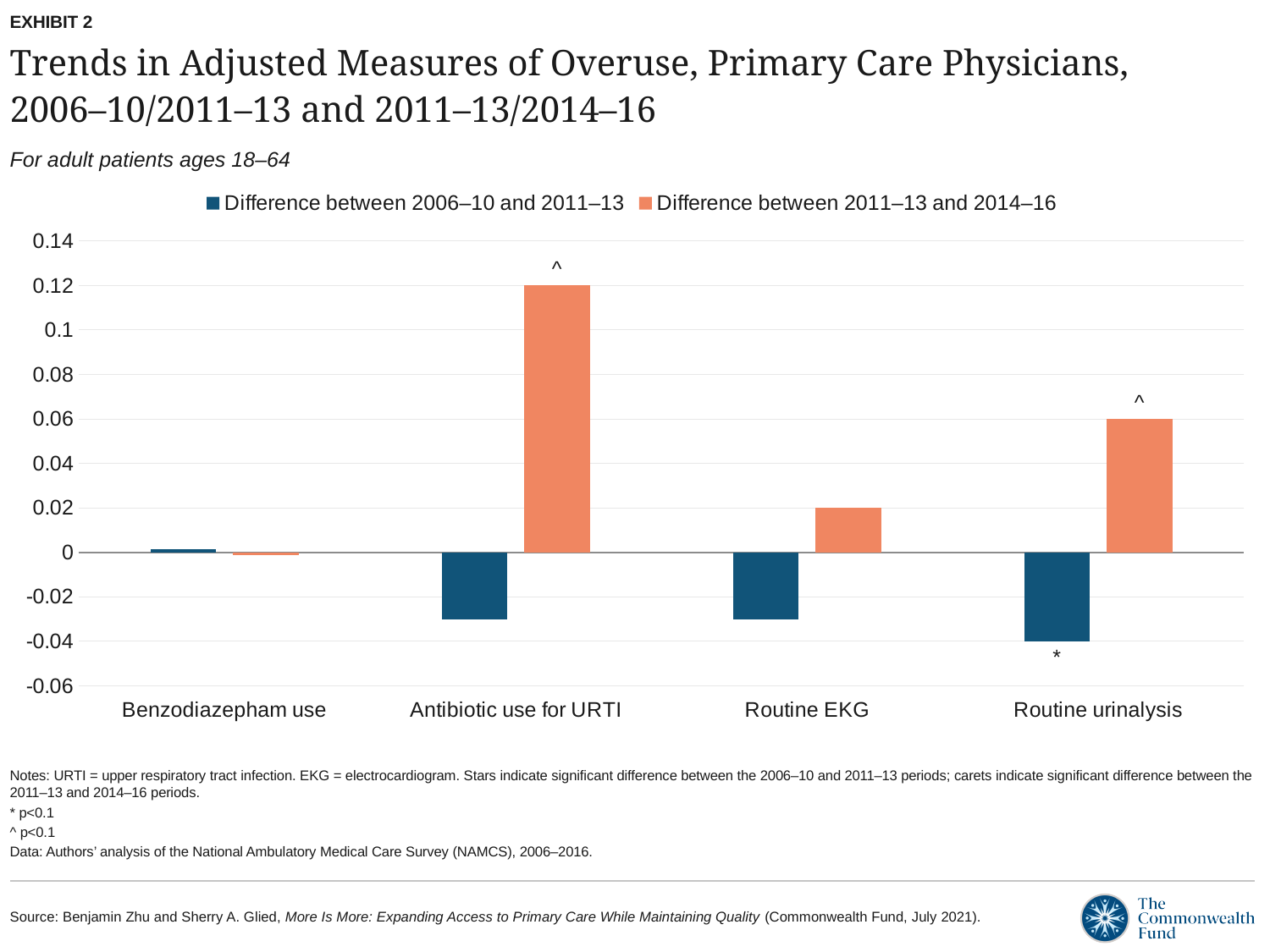
How many series does the legend list? 2 What colour are the bars for the 'Difference between 2011–13 and 2014–16' series? orange Which category has the highest value for the 'Difference between 2011–13 and 2014–16' series? Antibiotic use for URTI Is the value for Routine urinalysis in the 'Difference between 2011–13 and 2014–16' series greater or less than 0.04? greater Is the value for Antibiotic use for URTI in the 'Difference between 2011–13 and 2014–16' series greater or less than 0.1? greater Which category is marked with a star (*) indicating a significant difference between the 2006–10 and 2011–13 periods? Routine urinalysis Which is larger for Routine EKG: the 'Difference between 2011–13 and 2014–16' value or the 'Difference between 2006–10 and 2011–13' value? Difference between 2011–13 and 2014–16 What kind of chart is shown on the slide? bar chart Which category has the lowest value for the 'Difference between 2006–10 and 2011–13' series? Routine urinalysis Which category has a larger 'Difference between 2011–13 and 2014–16' value: Routine EKG or Routine urinalysis? Routine urinalysis Is the value for Routine EKG in the 'Difference between 2006–10 and 2011–13' series greater or less than 0? less How many categories are shown on the x axis? 4